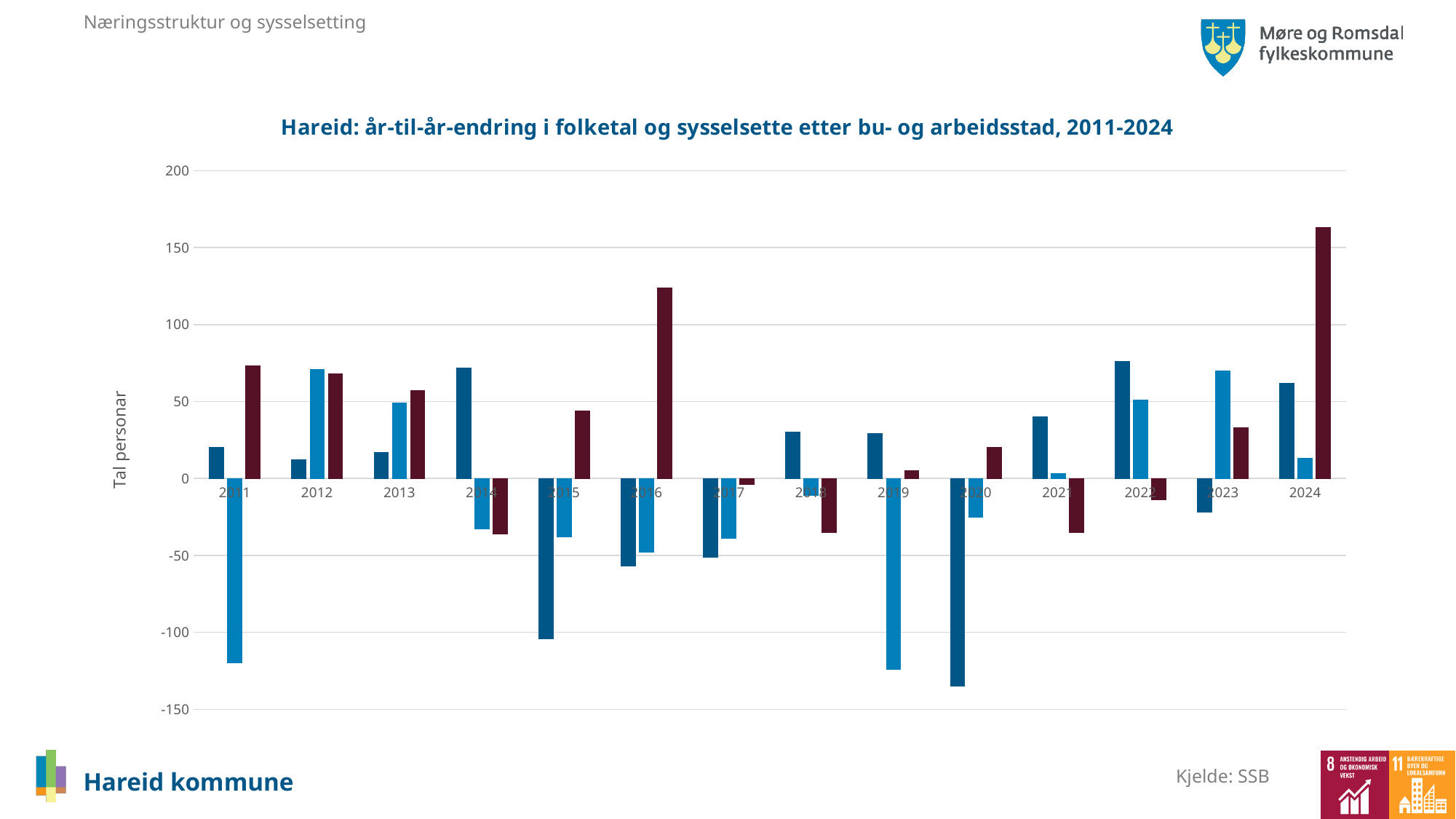
What kind of chart is shown on the slide? bar chart How many years are shown along the x axis of the chart? 14 Is the value of the dark red bar for 2024 greater or less than 150? greater In which year is the dark red bar the highest? 2024 Is the value of the dark red bar for 2016 greater or less than 100? greater Is the value of the dark blue bar for 2020 greater or less than -100? less In which year is the dark blue bar the lowest? 2020 What is the title of the chart? Hareid: år-til-år-endring i folketal og sysselsette etter bu- og arbeidsstad, 2011-2024 Which is larger: the dark red bar for 2016 or the dark red bar for 2011? 2016 What is the label on the vertical axis of the chart? Tal personar